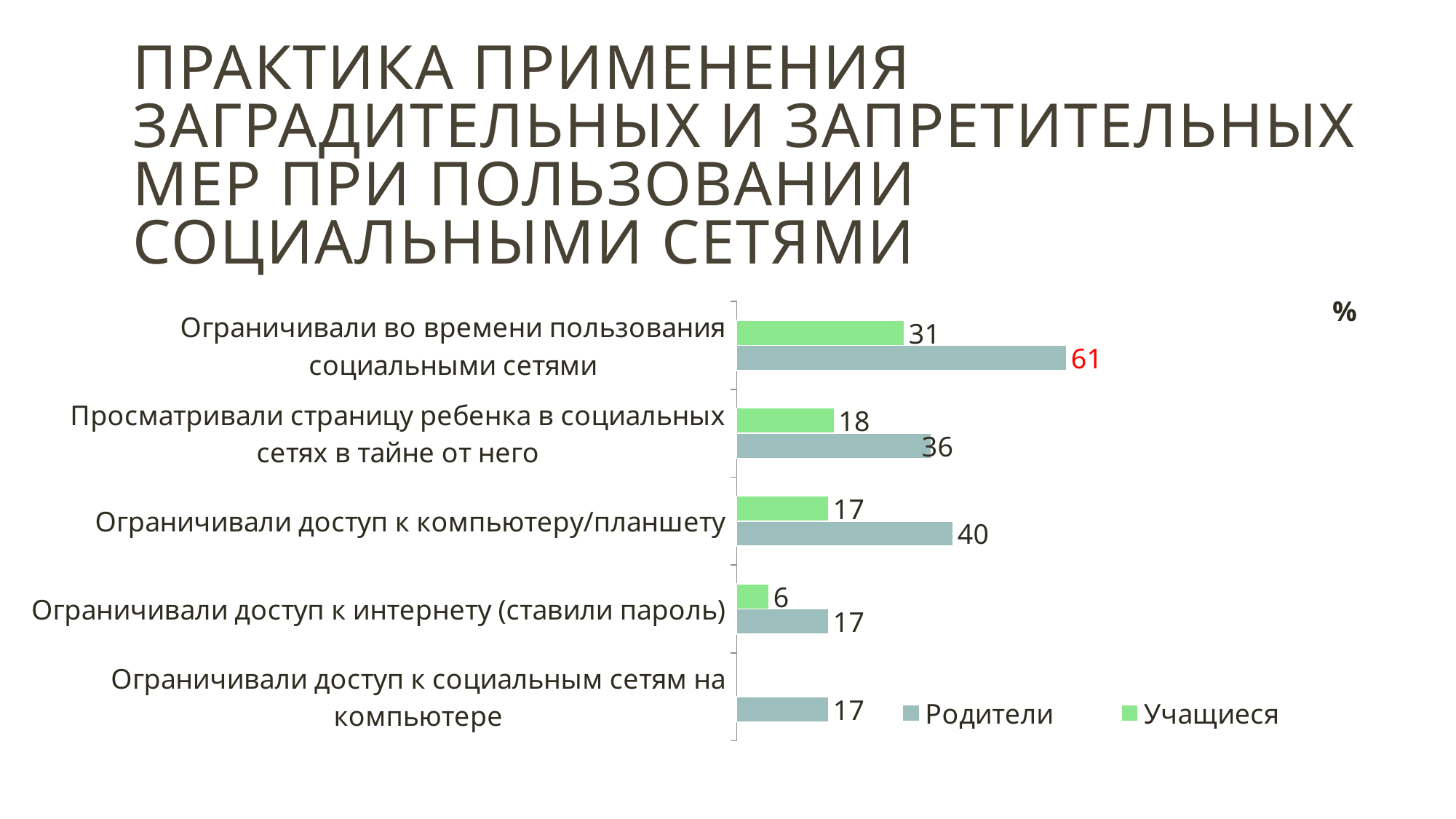
Which category has the highest value for Родители? Ограничивали во времени пользования социальными сетями What is the value for Родители for "Ограничивали доступ к компьютеру/планшету"? 40 What is the value for Учащиеся for "Просматривали страницу ребенка в социальных сетях в тайне от него"? 18 What is the value for Родители for "Ограничивали во времени пользования социальными сетями"? 61 How many series does the legend list? 2 Which series is shown in green in the legend? Учащиеся What is the value for Учащиеся for "Ограничивали доступ к интернету (ставили пароль)"? 6 Which is larger for "Ограничивали доступ к компьютеру/планшету": the Родители value or the Учащиеся value? Родители What is the difference between the Родители and Учащиеся values for "Ограничивали во времени пользования социальными сетями"? 30 What kind of chart is shown on the slide? Bar chart Which category has the lowest value for Учащиеся among those with a plotted Учащиеся bar? Ограничивали доступ к интернету (ставили пароль) How many categories are shown on the chart? 5